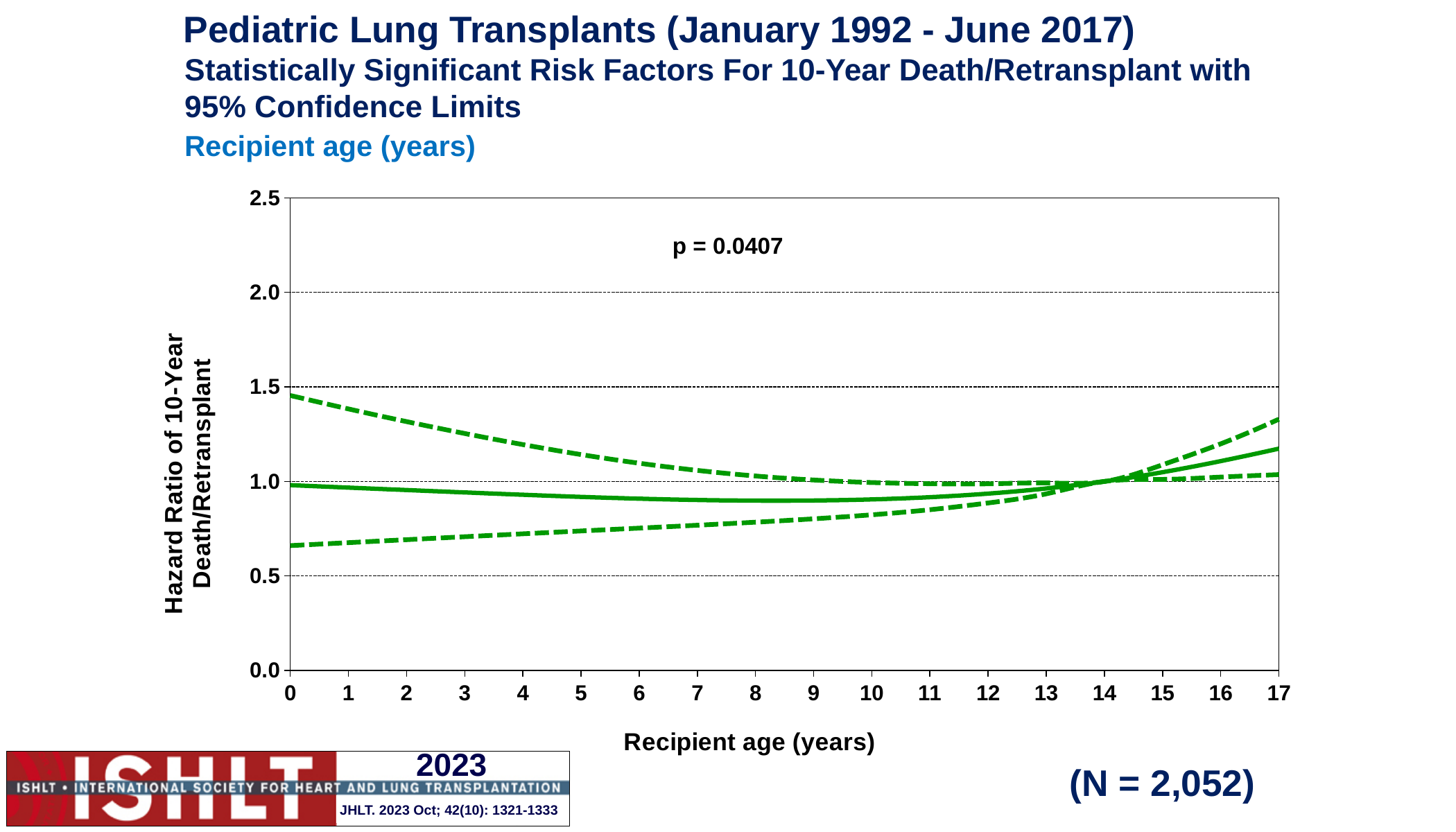
How many lines are plotted on the chart? 3 Is the lower confidence limit (lower dashed line) at recipient age 0 greater or less than 0.5? greater Does the upper confidence limit (upper dashed line) rise or fall as recipient age increases from 0 to 10? fall Does the lower confidence limit (lower dashed line) rise or fall as recipient age increases from 0 to 17? rise Is the upper confidence limit (upper dashed line) at recipient age 0 greater or less than 1.5? less What p-value is printed on the chart? p = 0.0407 Is the hazard ratio (solid line) at recipient age 17 greater or less than 1.0? greater What is the highest value shown on the y axis? 2.5 What is the sample size (N) shown on the slide? N = 2,052 What kind of chart is shown on the slide? line chart